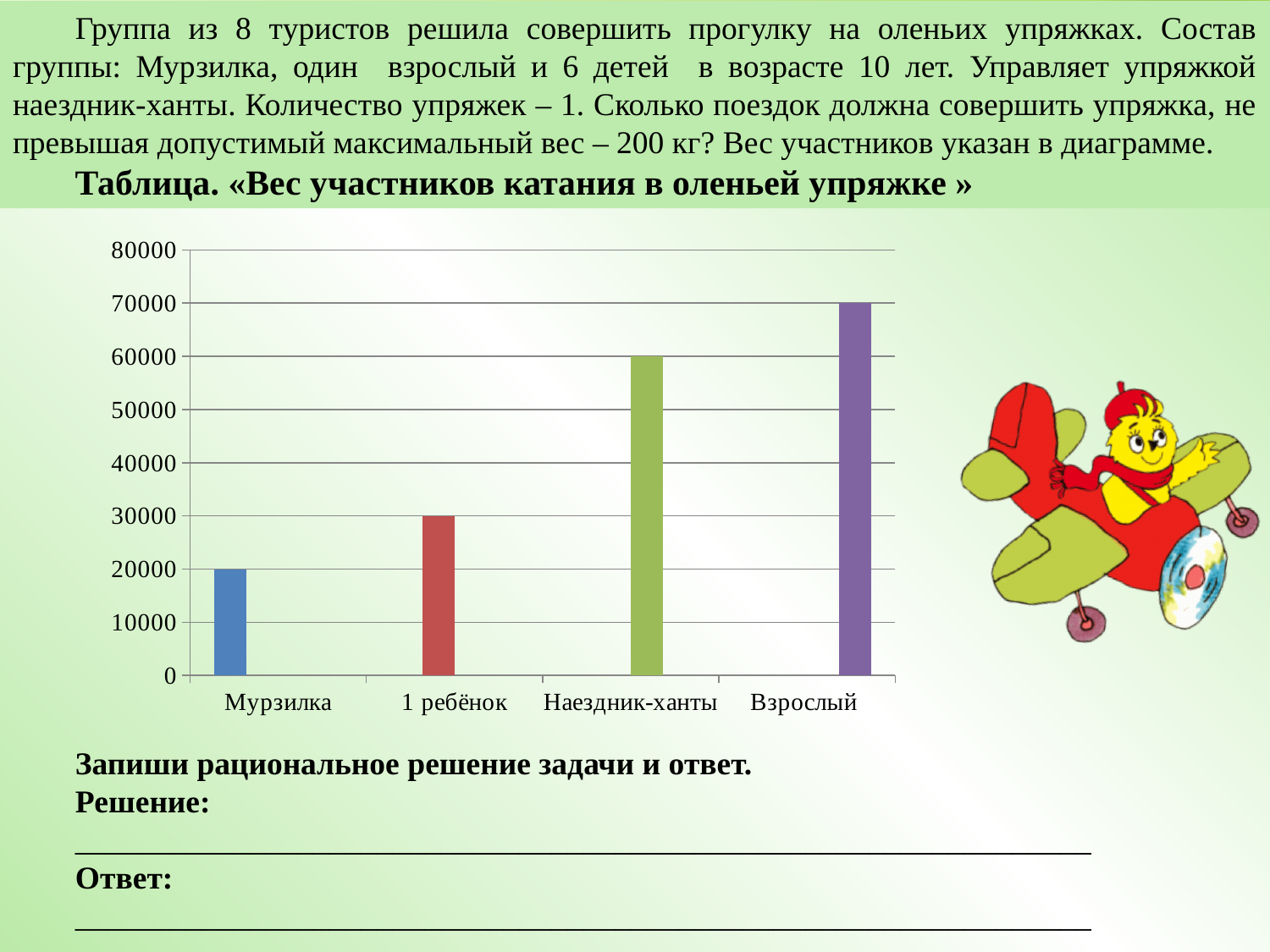
What is the maximum value shown on the vertical axis of the chart? 80000 What is the value for Взрослый? 70000 How many categories are shown on the x axis of the chart? 4 What kind of chart is shown on the slide? bar chart Which category has the highest value? Взрослый What is the difference between the values for Взрослый and Наездник-ханты? 10000 Which is larger, the value for 1 ребёнок or the value for Наездник-ханты? Наездник-ханты What is the value for 1 ребёнок? 30000 Do the values rise or fall from left to right along the x axis? rise What is the value for Наездник-ханты? 60000 Which category has the lowest value? Мурзилка What is the value for Мурзилка? 20000